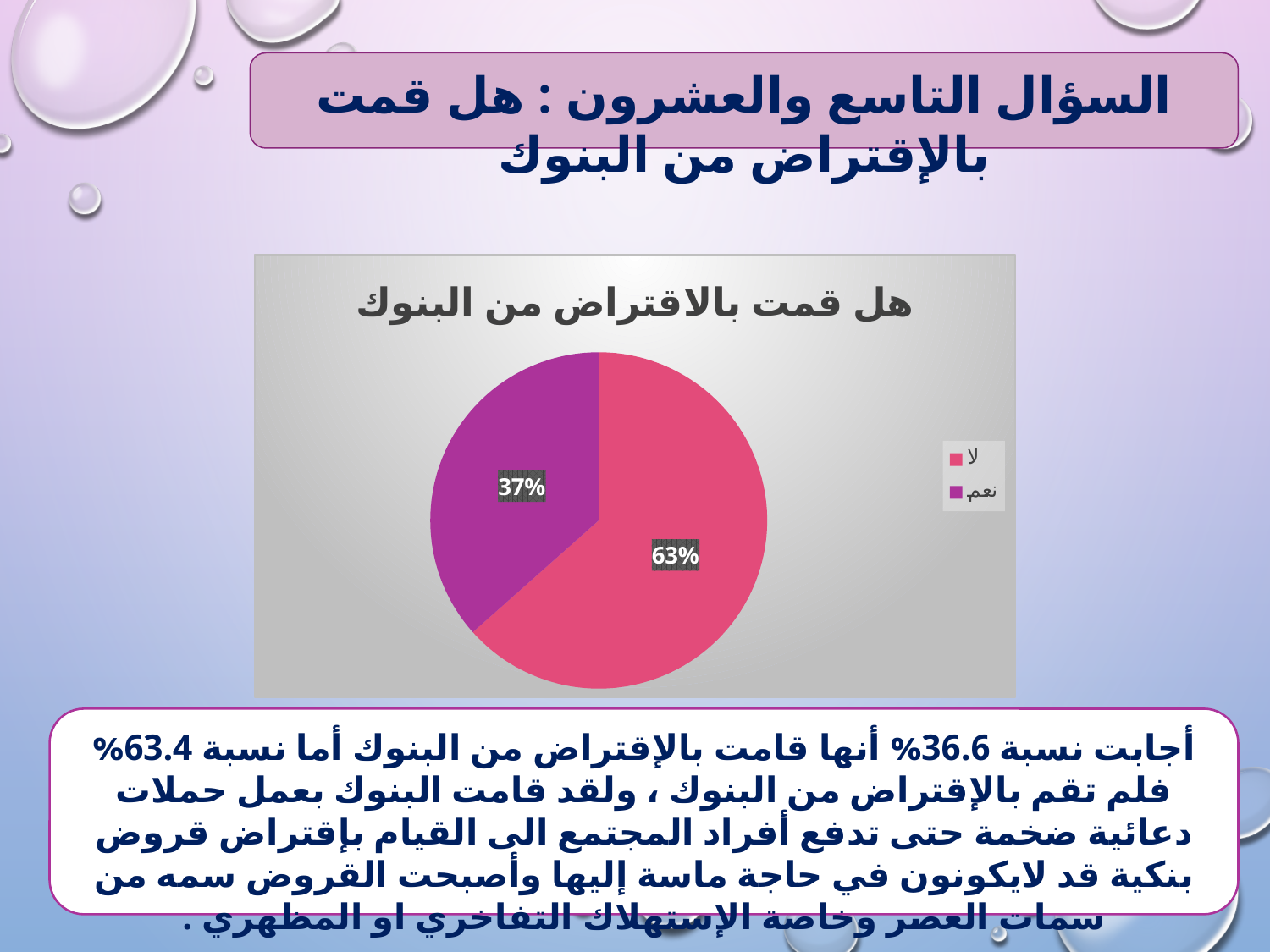
What share of the pie does the "نعم" slice represent? 37% How many entries does the legend list? 2 What colour is the slice for "نعم"? purple How many slices does the pie chart have? 2 What percentage of the pie is labelled for the category "لا"? 63% Which category has the largest slice of the pie? لا Which category has the smallest slice of the pie? نعم What is the difference in percentage points between the "لا" slice and the "نعم" slice? 26 What percentage of the pie is labelled for the category "نعم"? 37% What is the title of the chart? هل قمت بالاقتراض من البنوك Which slice is larger, "لا" or "نعم"? لا What kind of chart is shown on the slide? pie chart